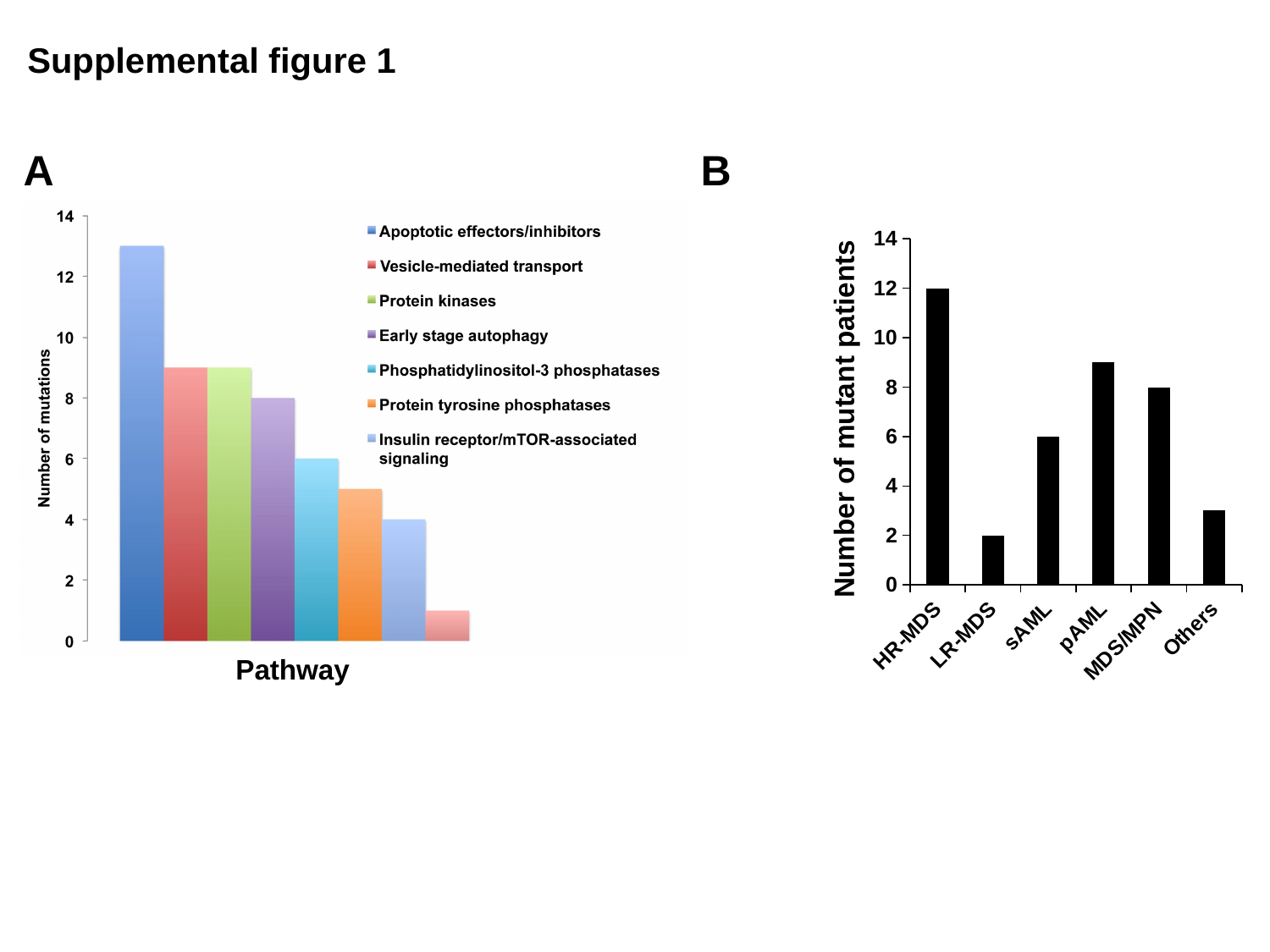
On chart B (right), which has more mutant patients, sAML or MDS/MPN? MDS/MPN On chart B (right), what is the number of mutant patients for MDS/MPN? 8 On chart A (left), which pathway has the highest number of mutations? Apoptotic effectors/inhibitors On chart B (right), how many mutant patients are shown for HR-MDS? 12 On chart B (right), what is the number of mutant patients for LR-MDS? 2 On chart B (right), what is the difference in number of mutant patients between HR-MDS and LR-MDS? 10 On chart B (right), how many categories are shown on the x axis? 6 On chart A (left), how many mutations are shown for Early stage autophagy? 8 On chart B (right), is the value for pAML greater or less than 10? less On chart A (left), how many mutations are shown for Insulin receptor/mTOR-associated signaling? 4 On chart A (left), how many entries does the legend list? 7 On chart B (right), which category has the lowest number of mutant patients? LR-MDS